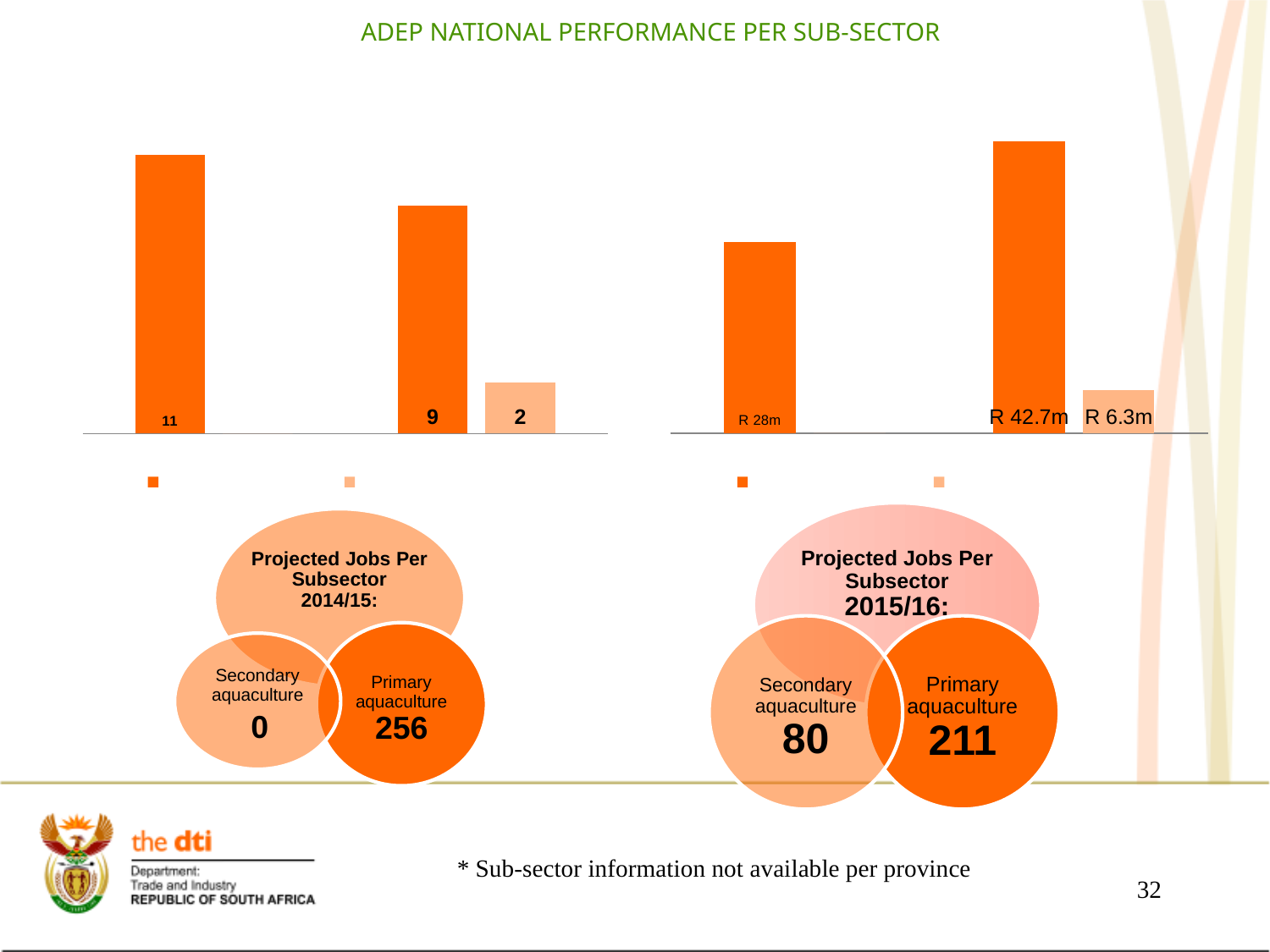
What kind of chart is the left chart on the slide? bar chart In the left chart, what is the value of the tallest bar? 11 In the left chart, what is the difference between the tallest bar (11) and the middle bar (9)? 2 How many bars are plotted in the left chart? 3 In the right chart, what is the value labelled on the leftmost bar? R 28m In the left chart, what is the value labelled on the rightmost (lighter) bar? 2 In the right chart, what is the value labelled on the tallest bar? R 42.7m In the right chart, which is larger: the leftmost bar (R 28m) or the middle bar (R 42.7m)? the middle bar (R 42.7m) How many bars are plotted in the right chart? 3 How many legend markers are shown beneath the left chart? 2 In the left chart, what is the value labelled on the leftmost bar? 11 In the right chart, what is the value of the shortest bar? R 6.3m